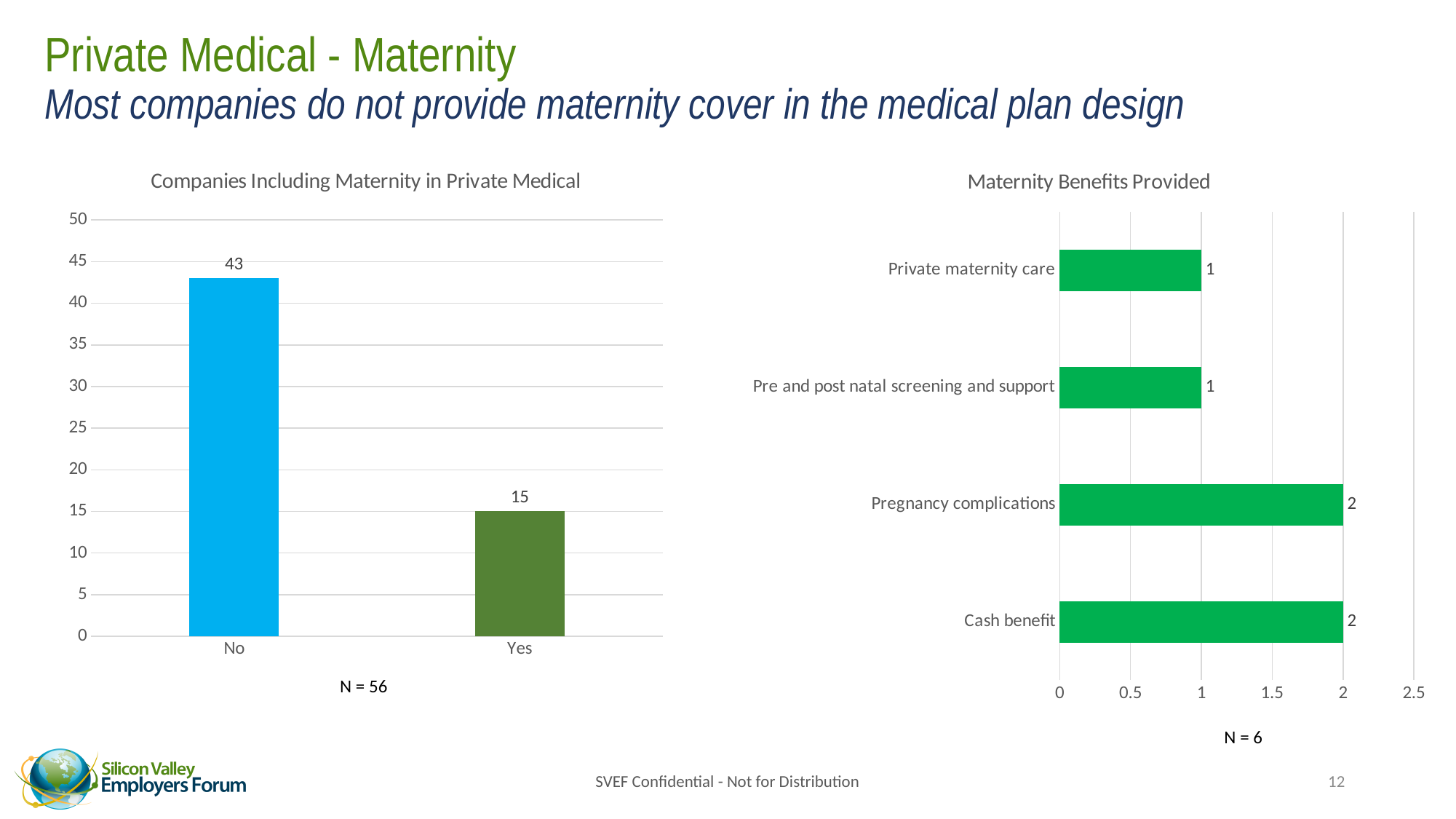
What is the sample size (N) shown under the 'Maternity Benefits Provided' chart? N = 6 In the 'Maternity Benefits Provided' chart, how many categories are shown? 4 In the 'Companies Including Maternity in Private Medical' chart, what is the value for No? 43 In the 'Maternity Benefits Provided' chart, what is the value for Private maternity care? 1 In the 'Companies Including Maternity in Private Medical' chart, which category has the higher value, No or Yes? No In the 'Companies Including Maternity in Private Medical' chart, what is the value for Yes? 15 In the 'Companies Including Maternity in Private Medical' chart, how many categories are shown? 2 In the 'Maternity Benefits Provided' chart, which is larger, the value for Cash benefit or the value for Pre and post natal screening and support? Cash benefit In the 'Companies Including Maternity in Private Medical' chart, what is the difference between the No and Yes values? 28 What kind of chart is 'Companies Including Maternity in Private Medical'? Bar chart In the 'Maternity Benefits Provided' chart, what is the value for Pregnancy complications? 2 In the 'Maternity Benefits Provided' chart, what is the difference between the values for Cash benefit and Private maternity care? 1